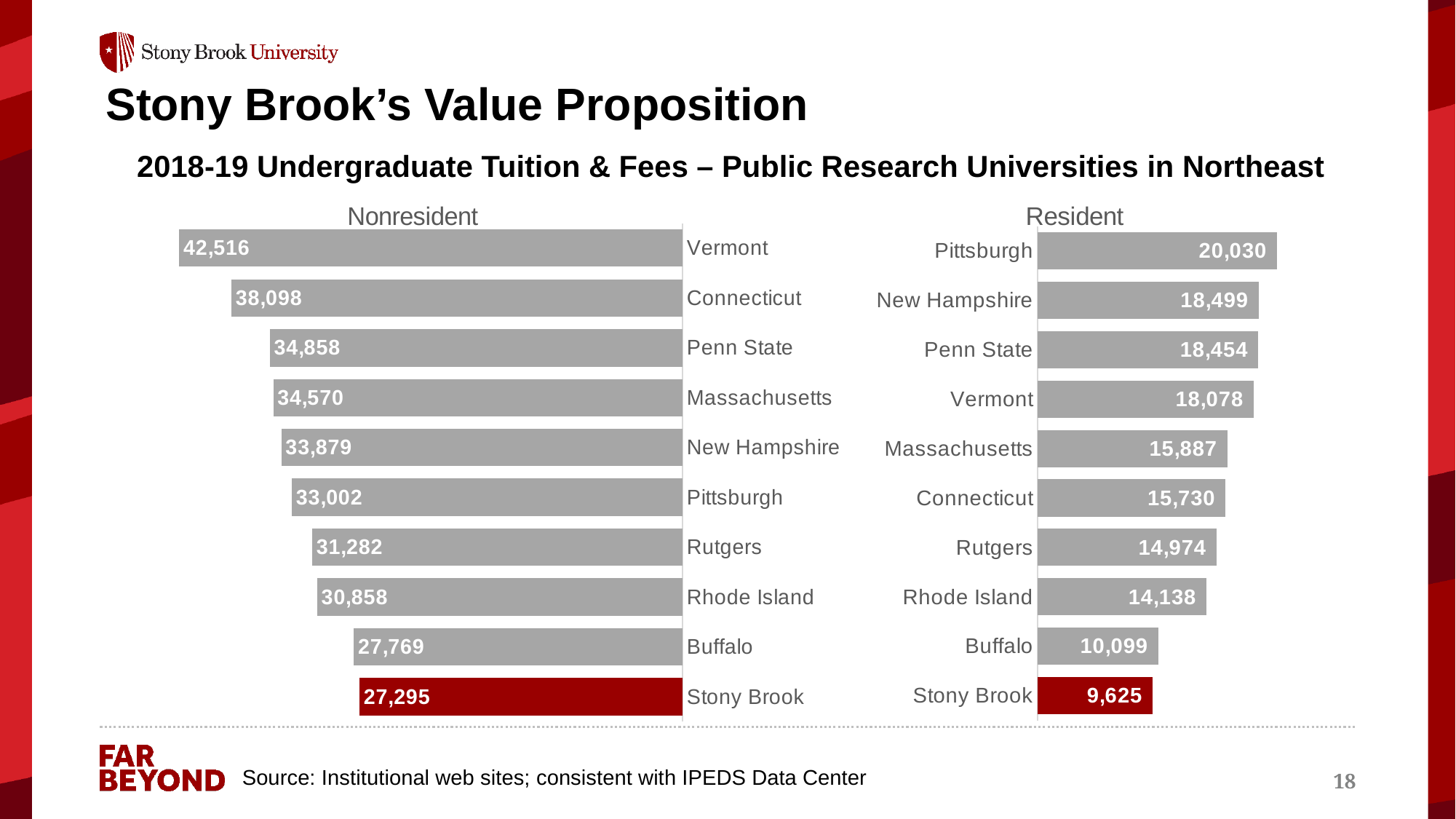
How many universities are shown in the Nonresident chart? 10 Which university's bars are coloured red rather than grey in both charts? Stony Brook In the Nonresident chart, which university has the lowest tuition and fees? Stony Brook In the Resident chart, what is the tuition and fees value for Stony Brook? 9,625 In the Nonresident chart, what is the value for Buffalo? 27,769 In the Resident chart, what is the value for New Hampshire? 18,499 In the Resident chart, what is the difference between Pittsburgh's value and Buffalo's value? 9,931 In the Nonresident chart, what is the tuition and fees value for Vermont? 42,516 What kind of chart is the Resident chart? Bar chart In the Resident chart, which is larger, the value for Buffalo or the value for Rhode Island? Rhode Island In the Nonresident chart, what is the difference between Vermont's value and Stony Brook's value? 15,221 In the Resident chart, which university has the highest tuition and fees? Pittsburgh